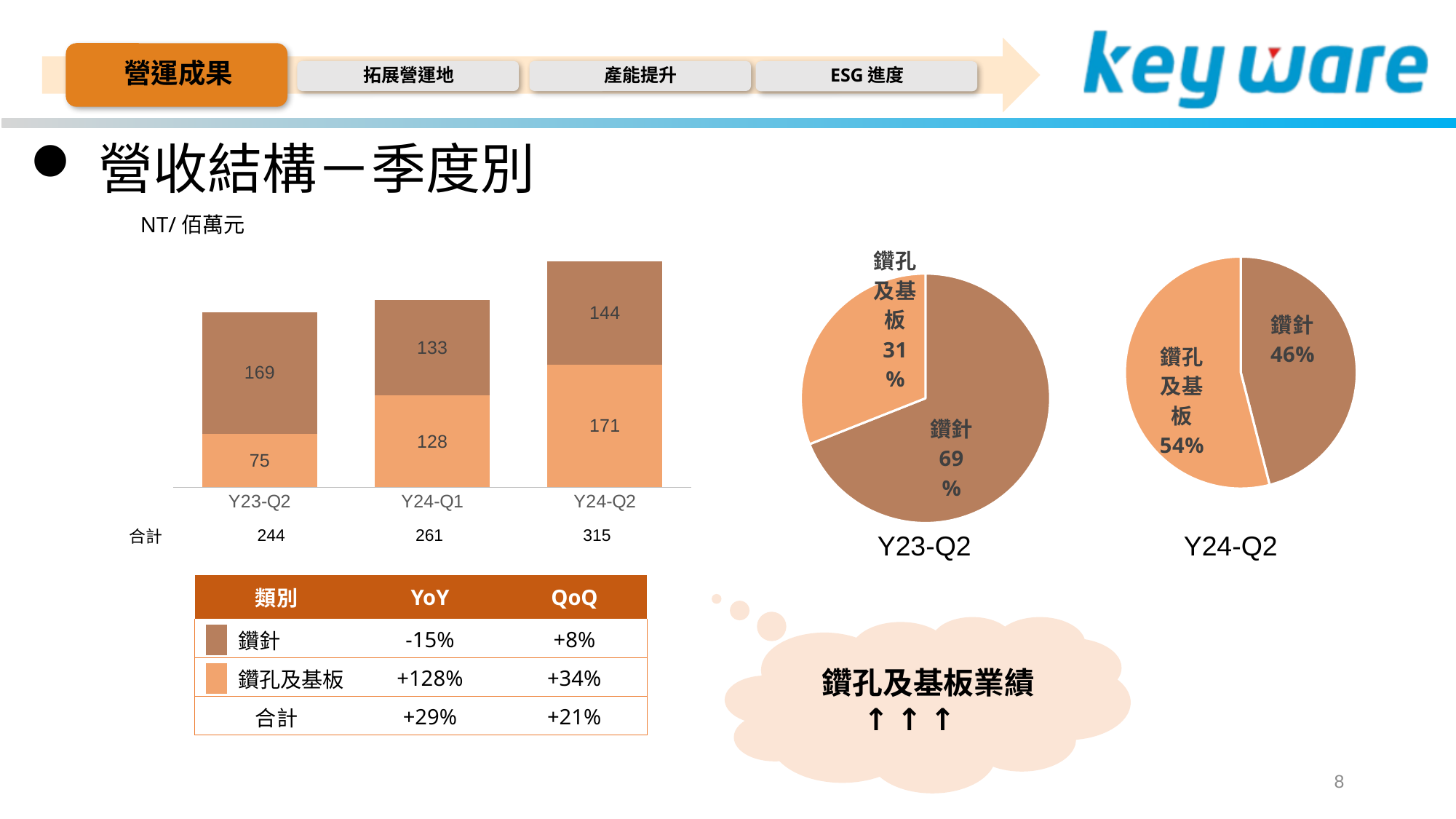
In the Y24-Q2 pie chart, what share does 鑽孔及基板 have? 54% In the stacked bar chart, which quarter has the highest total? Y24-Q2 How many quarters are shown on the x axis of the stacked bar chart? 3 In the Y23-Q2 pie chart, what share does 鑽針 have? 69% In the stacked bar chart, what is the value for 鑽孔及基板 in Y23-Q2? 75 In the stacked bar chart, what is the total (合計) of the Y24-Q2 bar? 315 In the stacked bar chart, do the totals rise or fall from Y23-Q2 to Y24-Q2? rise In the stacked bar chart, which quarter has the lowest value for 鑽孔及基板? Y23-Q2 In the stacked bar chart, what is the difference between the 鑽針 values for Y23-Q2 and Y24-Q1? 36 In the stacked bar chart, what is the value for 鑽孔及基板 in Y24-Q1? 128 In the stacked bar chart, what is the value for 鑽針 in Y24-Q2? 144 In the stacked bar chart, which is larger in Y24-Q2: 鑽針 or 鑽孔及基板? 鑽孔及基板